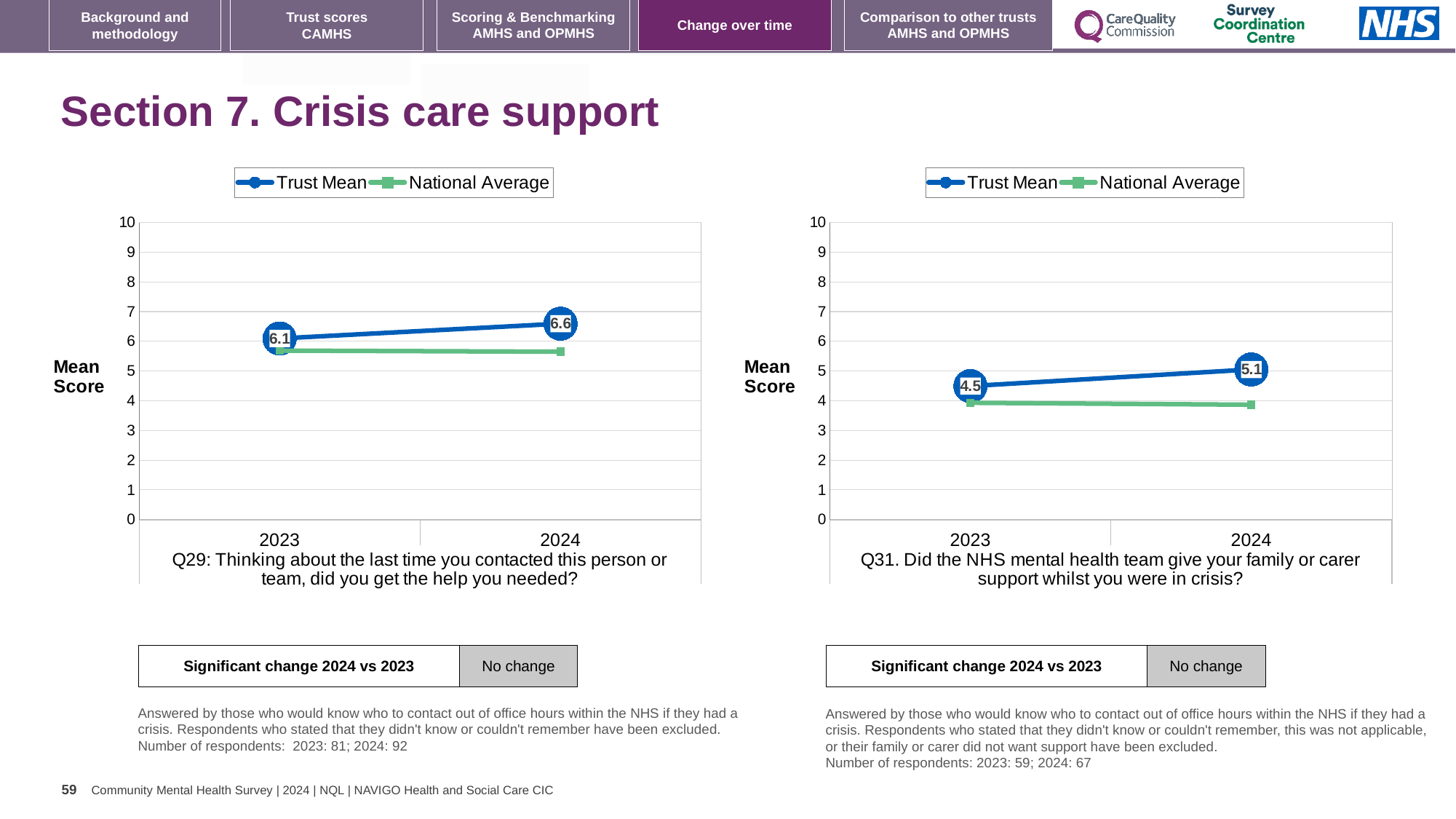
In the Q31 chart (right), what is the difference between the Trust Mean in 2024 and in 2023? 0.6 How many years are shown on the x axis of the Q29 chart (left)? 2 In the Q31 chart (right), what is the Trust Mean score for 2023? 4.5 In the Q29 chart (left), by how much did the Trust Mean change from 2023 to 2024? 0.5 How many series does the legend of the Q31 chart (right) list? 2 In the Q31 chart (right), is the National Average for 2024 greater or less than 5? less In the Q31 chart (right), does the Trust Mean rise or fall from 2023 to 2024? rise What type of chart is used for Q29 on the left? line chart In the Q29 chart (left), what is the Trust Mean score for 2023? 6.1 In the Q29 chart (left), what is the Trust Mean score for 2024? 6.6 In the Q31 chart (right), what is the Trust Mean score for 2024? 5.1 In the Q29 chart (left), which series has the higher value in 2024, Trust Mean or National Average? Trust Mean